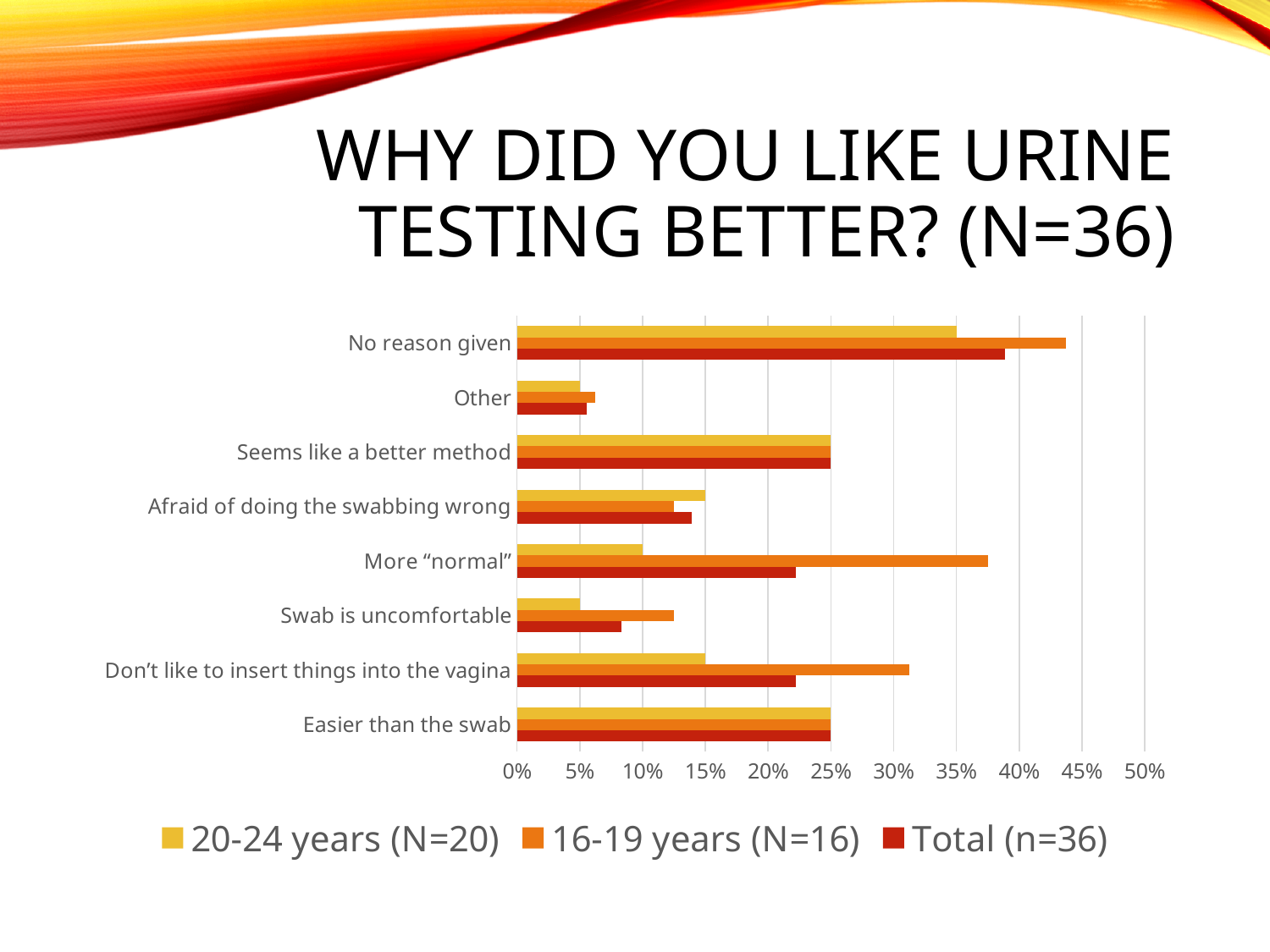
What is the value for 20-24 years (N=20) for "More "normal""? 10% Which category has the lowest value for Total (n=36)? Other What kind of chart is shown on the slide? bar chart What is the value for 20-24 years (N=20) for "No reason given"? 35% Is the value for 16-19 years (N=16) for "Don't like to insert things into the vagina" greater or less than 25%? greater Is the value for Total (n=36) for "No reason given" greater or less than 35%? greater For "More "normal"", which is larger: the value for 16-19 years (N=16) or for 20-24 years (N=20)? 16-19 years (N=16) What is the value for 20-24 years (N=20) for "Seems like a better method"? 25% Which category has the highest value for 16-19 years (N=16)? No reason given How many series does the legend list? 3 How many reason categories are plotted on the chart? 8 What is the value for Total (n=36) for "Easier than the swab"? 25%